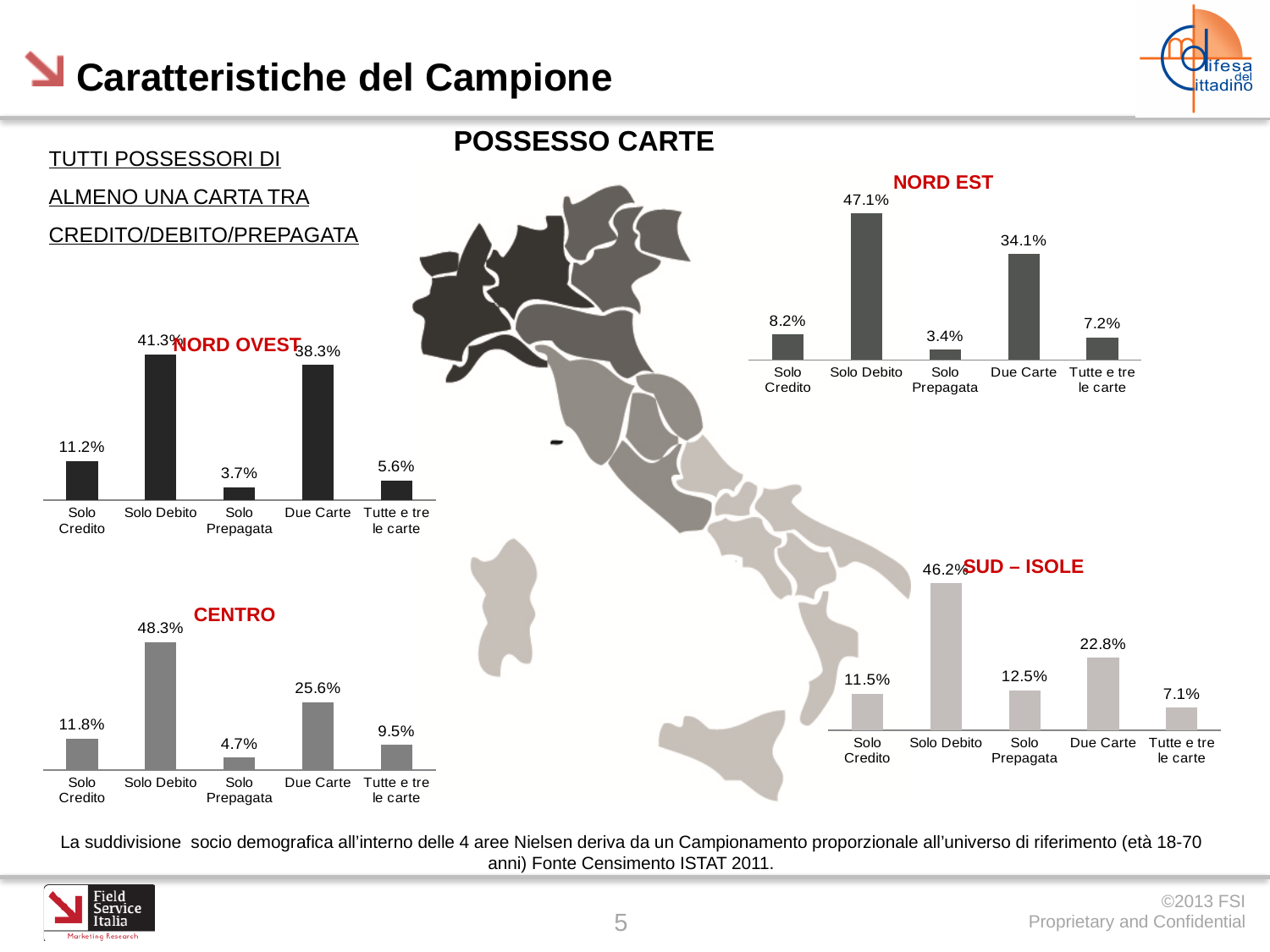
How many categories does the NORD EST chart show? 5 What kind of chart is the CENTRO chart? Bar chart In the NORD OVEST chart, what is the difference between Solo Debito and Due Carte? 3.0% In the NORD EST chart, what is the value for Due Carte? 34.1% In the CENTRO chart, which category has the highest value? Solo Debito In the SUD – ISOLE chart, what is the difference between Due Carte and Tutte e tre le carte? 15.7% In the SUD – ISOLE chart, which is larger: Solo Credito or Solo Prepagata? Solo Prepagata In the CENTRO chart, what is the value for Tutte e tre le carte? 9.5% In the SUD – ISOLE chart, what is the value for Solo Prepagata? 12.5% In the NORD EST chart, which category has the lowest value? Solo Prepagata In the NORD OVEST chart, what is the value for Solo Debito? 41.3% How many regional bar charts are shown on the slide? 4